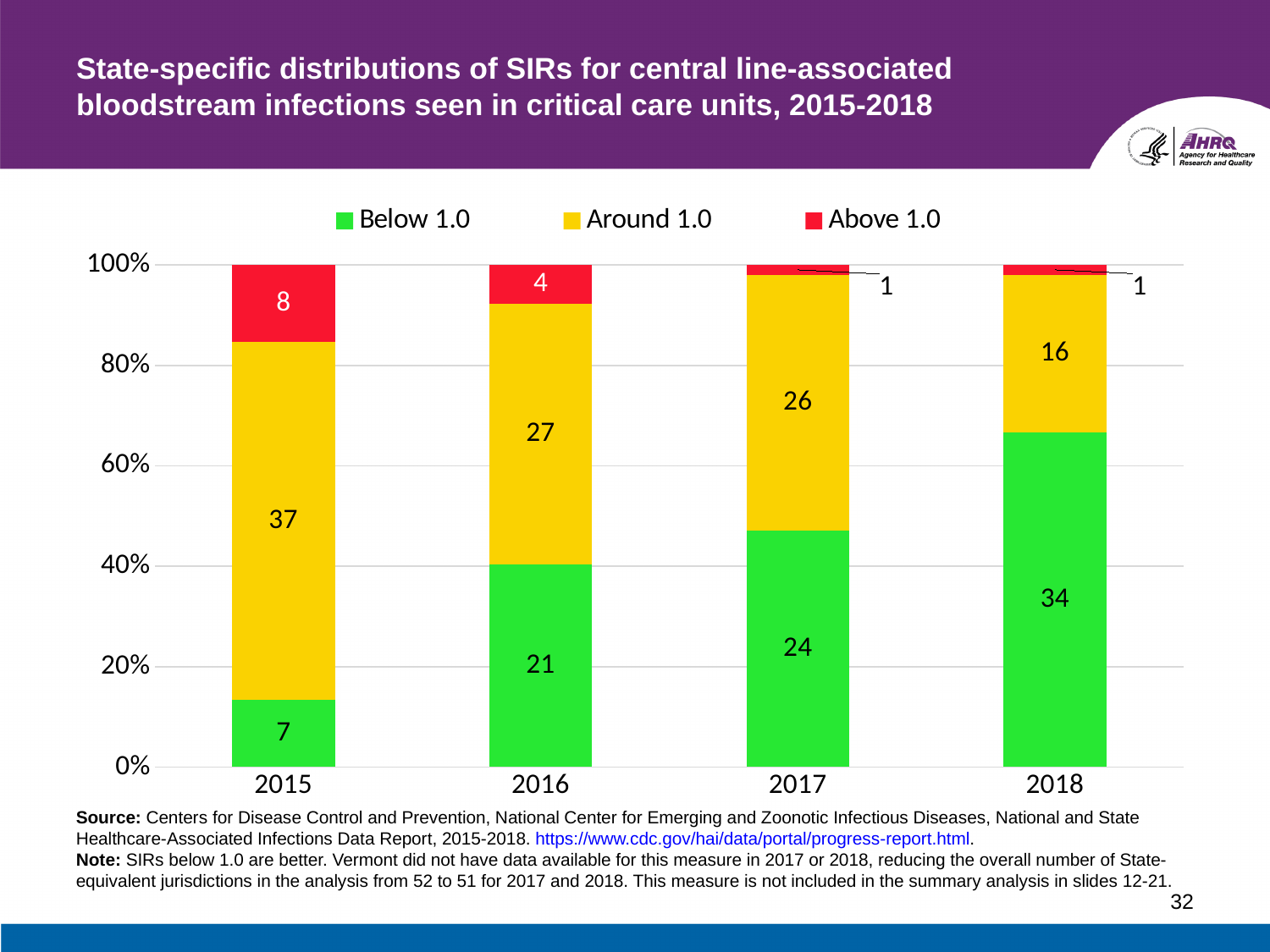
How many years are shown on the x axis? 4 What kind of chart is shown on the slide? Stacked bar chart In which year is the Around 1.0 count lowest? 2018 How many series does the legend list? 3 Does the Below 1.0 count rise or fall from 2015 to 2018? Rise What is the value for Around 1.0 in 2017? 26 What is the difference between the Below 1.0 values for 2018 and 2015? 27 What is the value for Above 1.0 in 2016? 4 Which is larger in 2016: the Below 1.0 value or the Around 1.0 value? Around 1.0 How many states had an SIR below 1.0 in 2015? 7 In which year is the Below 1.0 count highest? 2018 What is the total number of states represented in the 2017 bar? 51